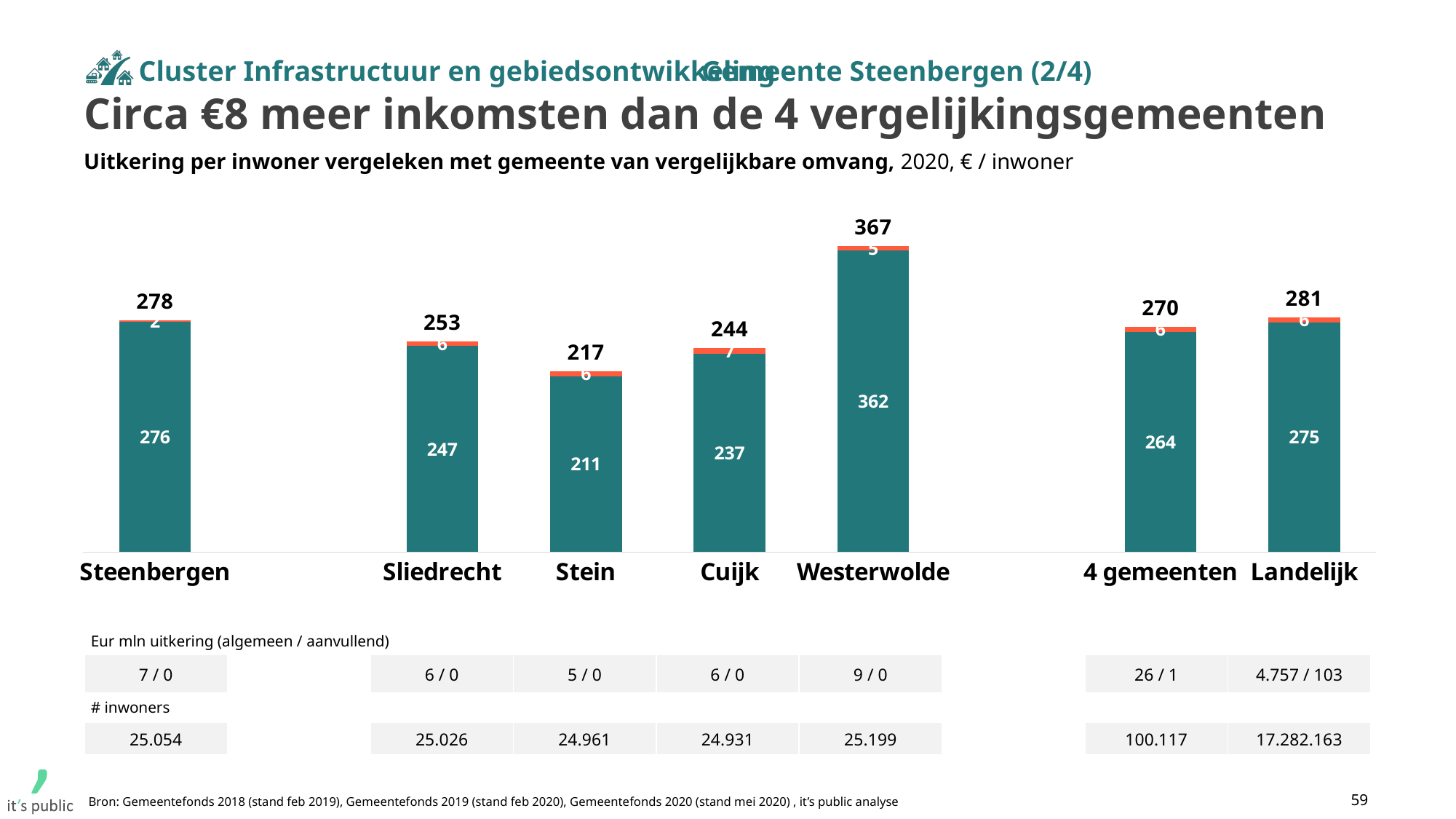
How many categories are shown on the x axis of the chart? 7 Which has a larger total value, Sliedrecht or Cuijk? Sliedrecht What is the difference between the total for Landelijk and the total for Steenbergen? 3 Which category has the lowest total value? Stein What is the difference between the total for Steenbergen and the total for 4 gemeenten? 8 What is the total value shown above the bar for Stein? 217 What is the value of the teal (lower) segment for Landelijk? 275 What is the value of the teal (lower) segment for Steenbergen? 276 Which category has the highest total value? Westerwolde What is the value of the teal (lower) segment for Westerwolde? 362 What kind of chart is shown on the slide? Stacked bar chart What is the total value shown above the bar for Westerwolde? 367